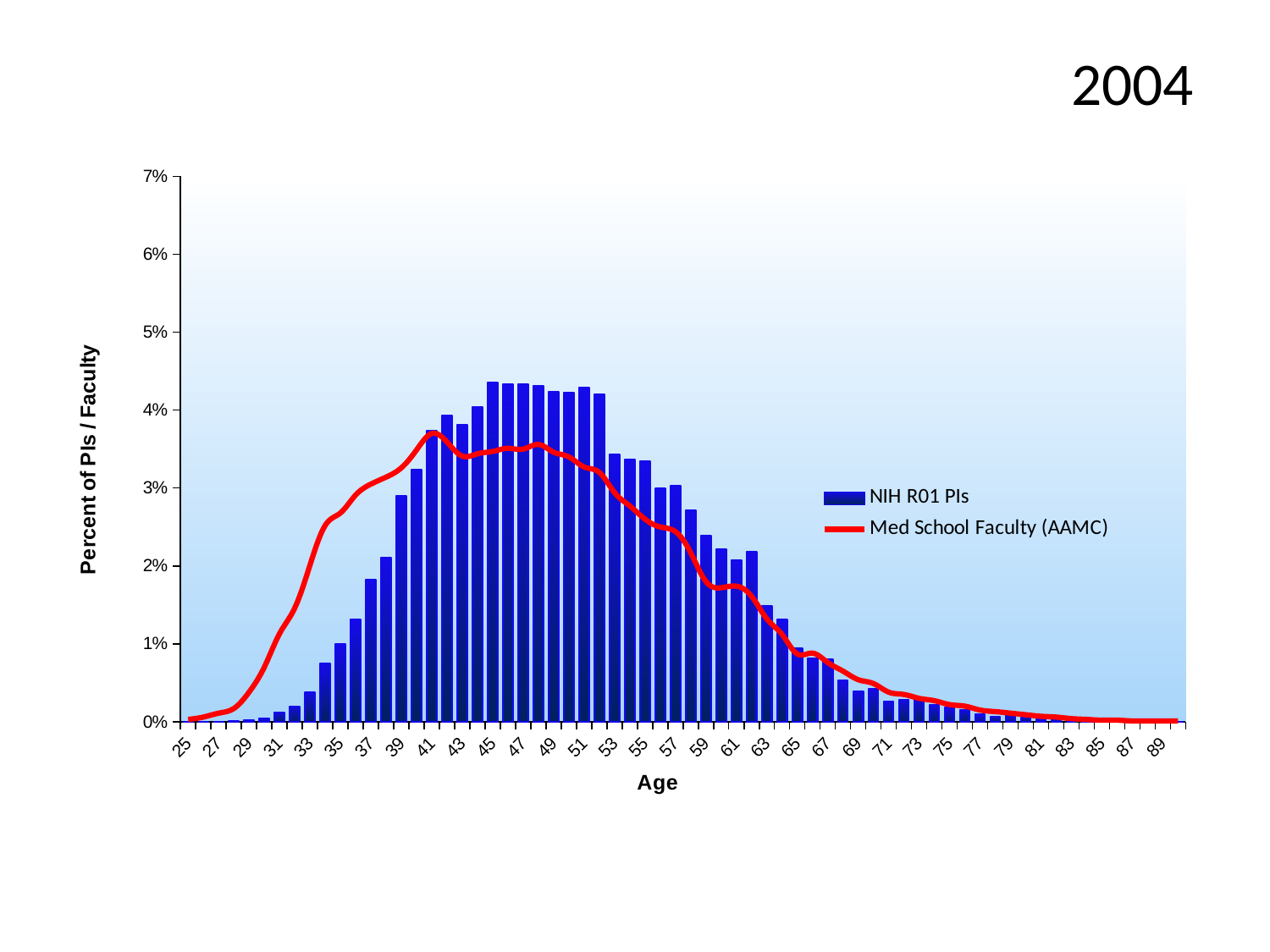
Is the NIH R01 PIs value at age 55 greater or less than 3%? greater What is the title shown at the top of the slide? 2004 How many series does the legend list? 2 Is the Med School Faculty (AAMC) value at age 35 greater or less than 2%? greater Is the Med School Faculty (AAMC) value at age 41 greater or less than 3%? greater What is the label of the vertical axis? Percent of PIs / Faculty What kind of chart is shown on the slide? Bar chart with a line overlay At age 33, which series has the higher value, NIH R01 PIs or Med School Faculty (AAMC)? Med School Faculty (AAMC) At age 45, which series has the higher value, NIH R01 PIs or Med School Faculty (AAMC)? NIH R01 PIs Do the NIH R01 PIs values rise or fall from age 65 to age 89? fall